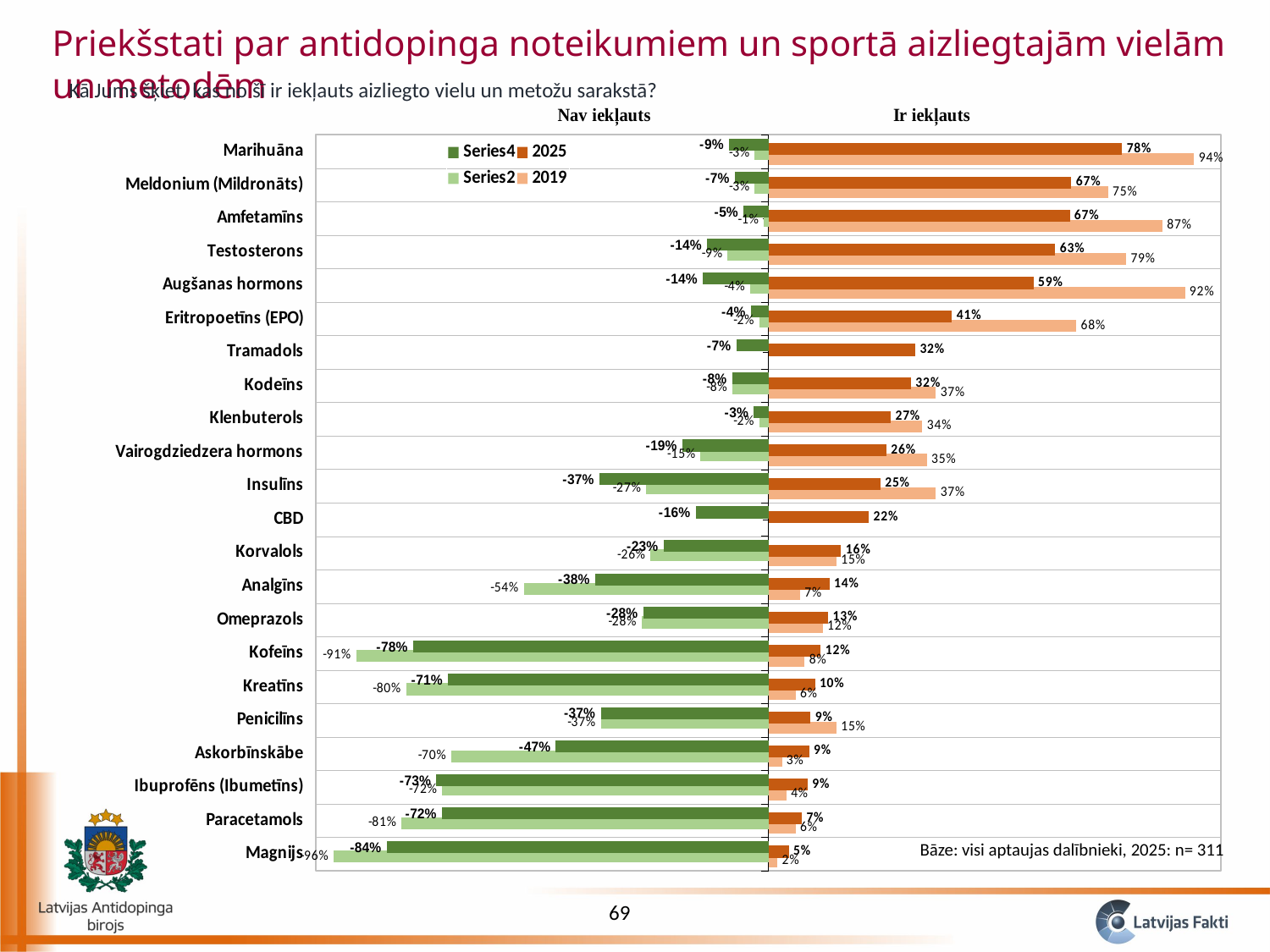
By how many percentage points did the "Ir iekļauts" value for Marihuāna change from 2019 (94%) to 2025 (78%)? 16 percentage points What type of chart is shown on the slide? Bar chart How many entries does the chart legend list? 4 What is the base (sample size) stated on the chart for 2025? n= 311 What is the 2019 "Ir iekļauts" value for Augšanas hormons? 92% Which is larger for Analgīns: the 2025 "Ir iekļauts" value or the 2019 "Ir iekļauts" value? 2025 (14%) How many substances are listed on the chart? 22 Which substance has the lowest 2025 "Ir iekļauts" value? Magnijs What is the 2025 "Nav iekļauts" value for Insulīns? -37% What is the 2019 "Nav iekļauts" value for Kofeīns? -91% What is the 2025 "Ir iekļauts" value for Marihuāna? 78% Which substance has the highest 2025 "Ir iekļauts" value? Marihuāna